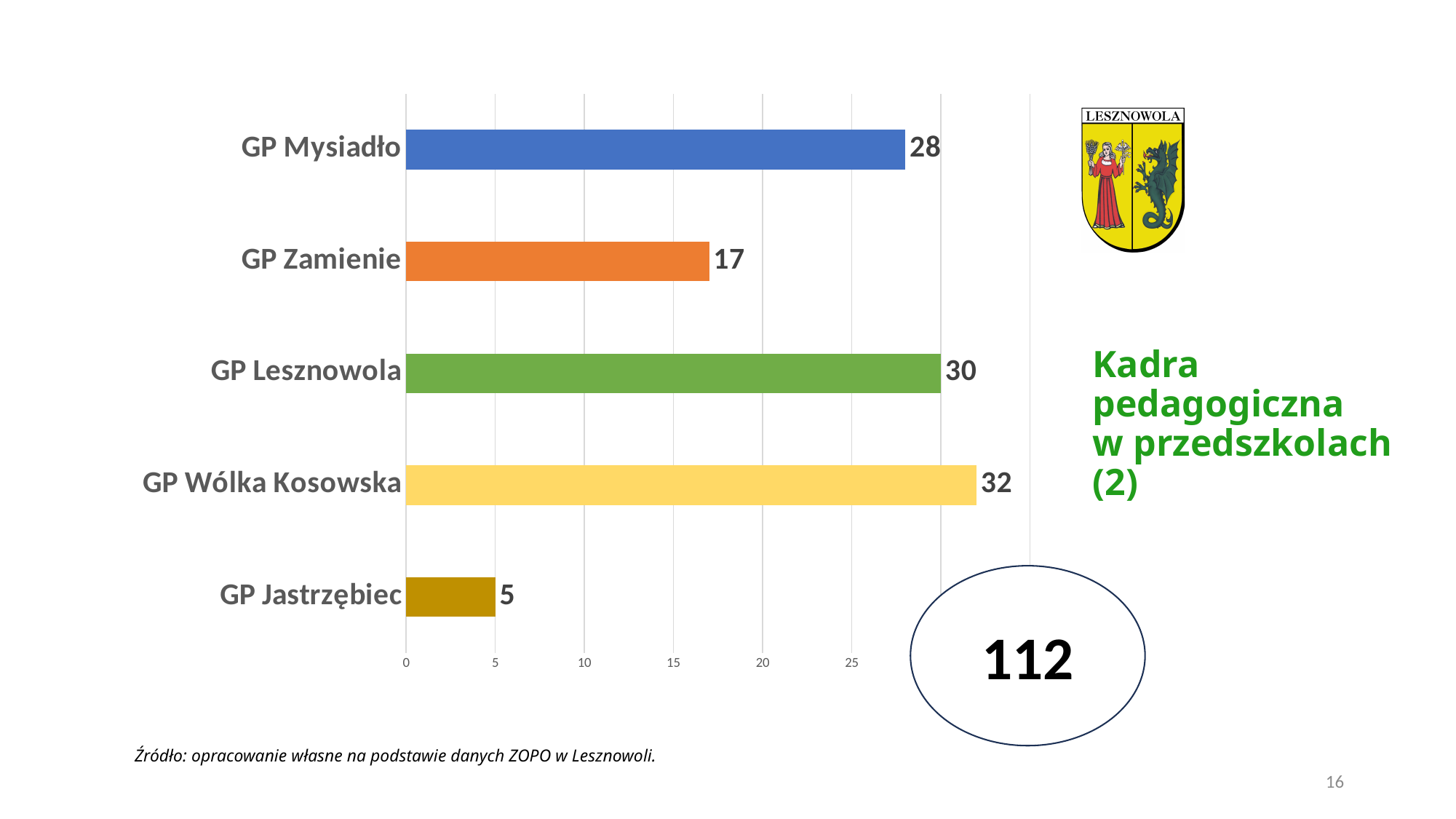
What is the value for GP Mysiadło? 28 What is the difference between the values for GP Wólka Kosowska and GP Zamienie? 15 Which category has the highest value? GP Wólka Kosowska Which category has the lowest value? GP Jastrzębiec What is the value for GP Jastrzębiec? 5 Which is larger, the value for GP Mysiadło or the value for GP Zamienie? GP Mysiadło How many categories are shown in the chart? 5 What number is shown in the circle next to the chart? 112 What is the value for GP Zamienie? 17 What kind of chart is shown on the slide? bar chart